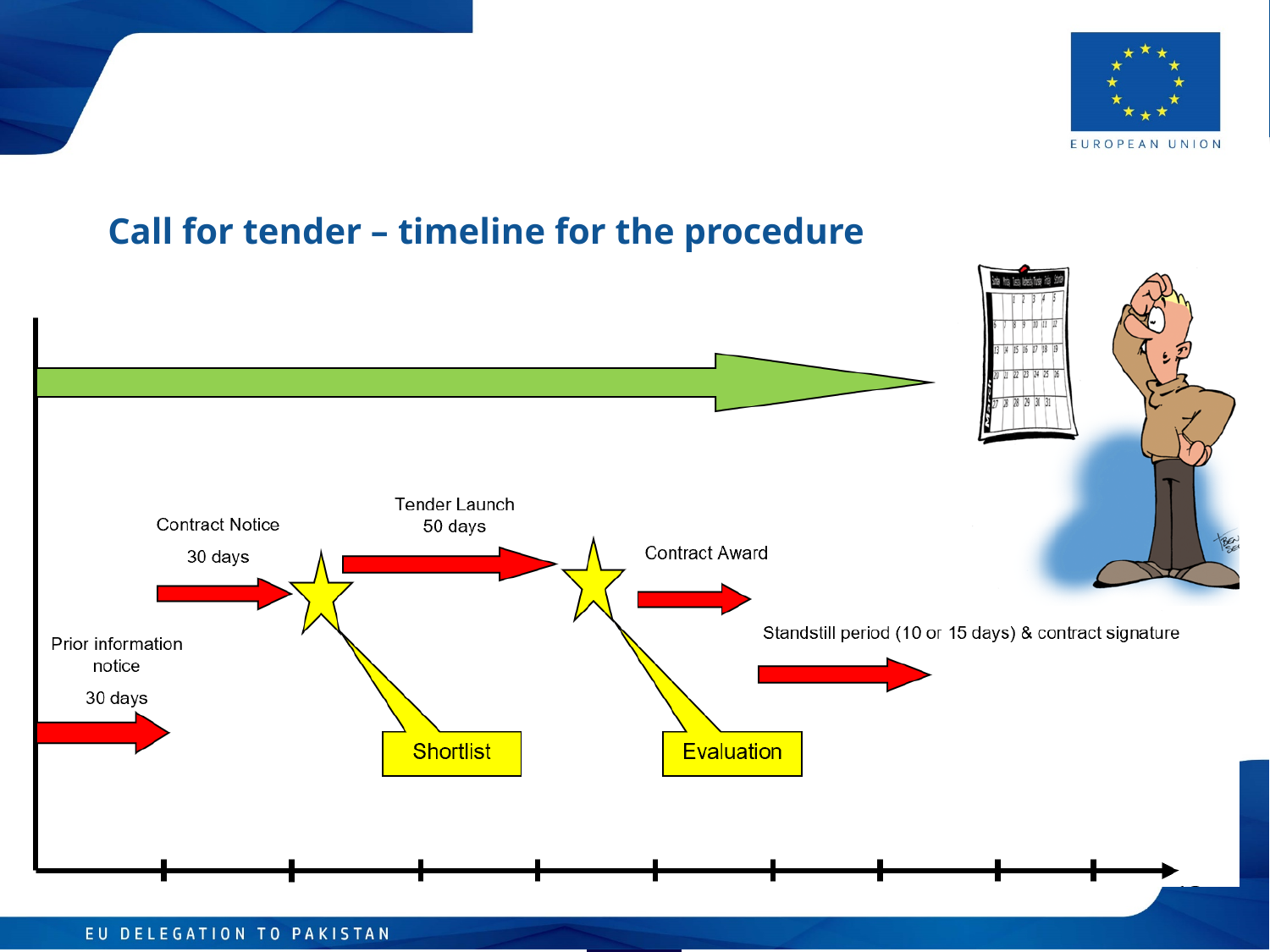
How long is the Standstill period shown after Contract Award? 10 or 15 days Which is longer, the Tender Launch stage or the Contract Notice stage? Tender Launch What label is shown in the yellow box linked to the second star on the timeline? Evaluation How many days are shown for the Tender Launch stage? 50 days What is the difference in days between the Tender Launch stage and the Contract Notice stage? 20 days What is the title of the timeline diagram on the slide? Call for tender – timeline for the procedure How many yellow stars are shown on the timeline? 2 What label is shown in the yellow box linked to the first star on the timeline? Shortlist Which stage has the longest duration printed on the timeline: Prior information notice, Contract Notice or Tender Launch? Tender Launch What kind of diagram is shown on the slide? Timeline How many days are shown for the Contract Notice stage? 30 days How many days are shown for the Prior information notice stage? 30 days